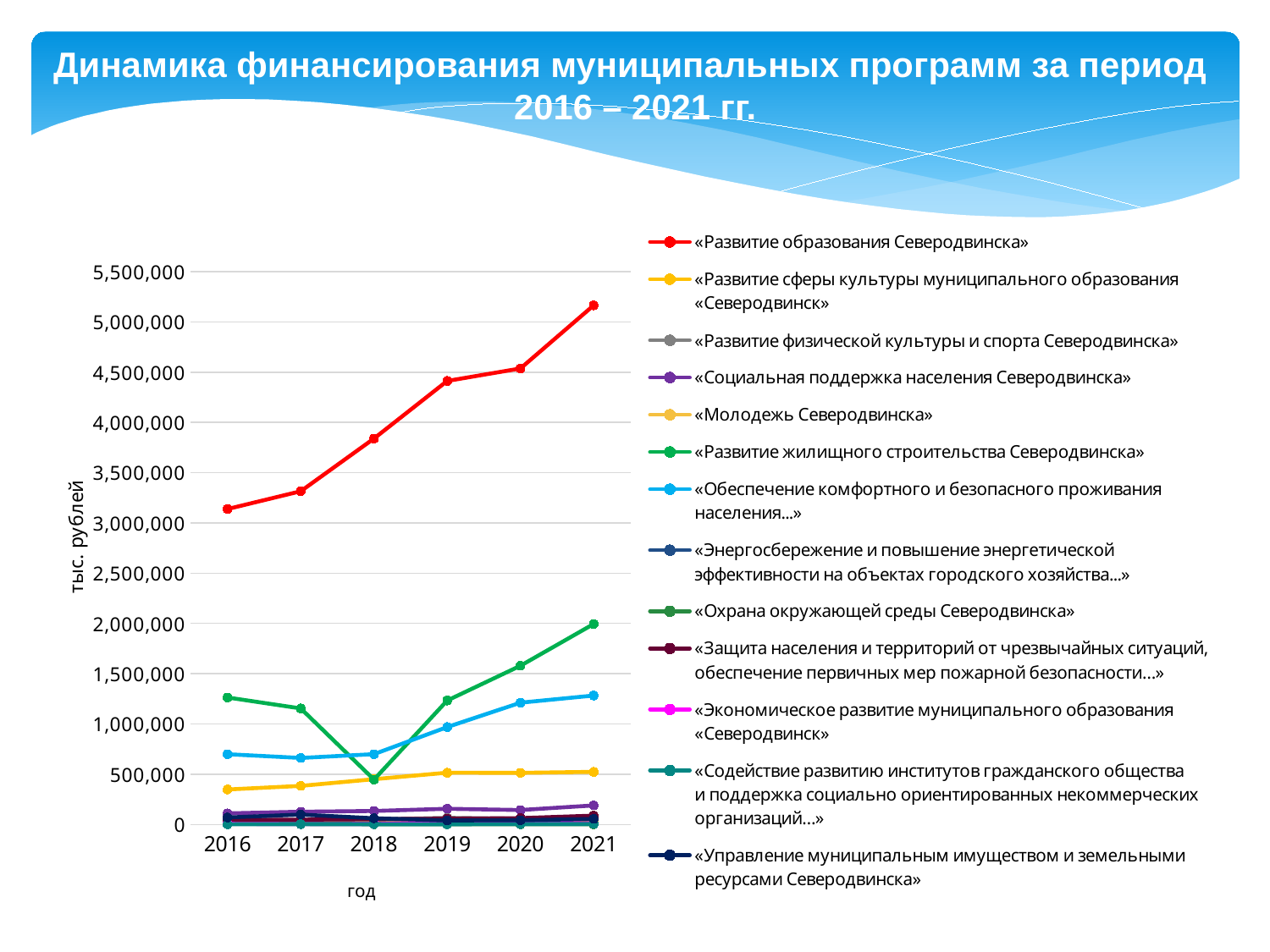
Is the value for «Развитие образования Северодвинска» in 2021 greater or less than 5,000,000? greater In which year is the value for «Развитие образования Северодвинска» lowest? 2016 What kind of chart is shown on the slide? line chart How many years are plotted along the x axis? 6 Is the value for «Развитие образования Северодвинска» in 2016 greater or less than 3,000,000? greater In 2016, which is larger: «Развитие жилищного строительства Северодвинска» or «Обеспечение комфортного и безопасного проживания населения...»? «Развитие жилищного строительства Северодвинска» Is the value for «Обеспечение комфортного и безопасного проживания населения...» in 2021 greater or less than 1,000,000? greater Does the value for «Развитие образования Северодвинска» rise or fall from 2016 to 2021? rise What is the label of the vertical axis? тыс. рублей How many series does the legend list? 13 Which series has the highest value in 2021? «Развитие образования Северодвинска»